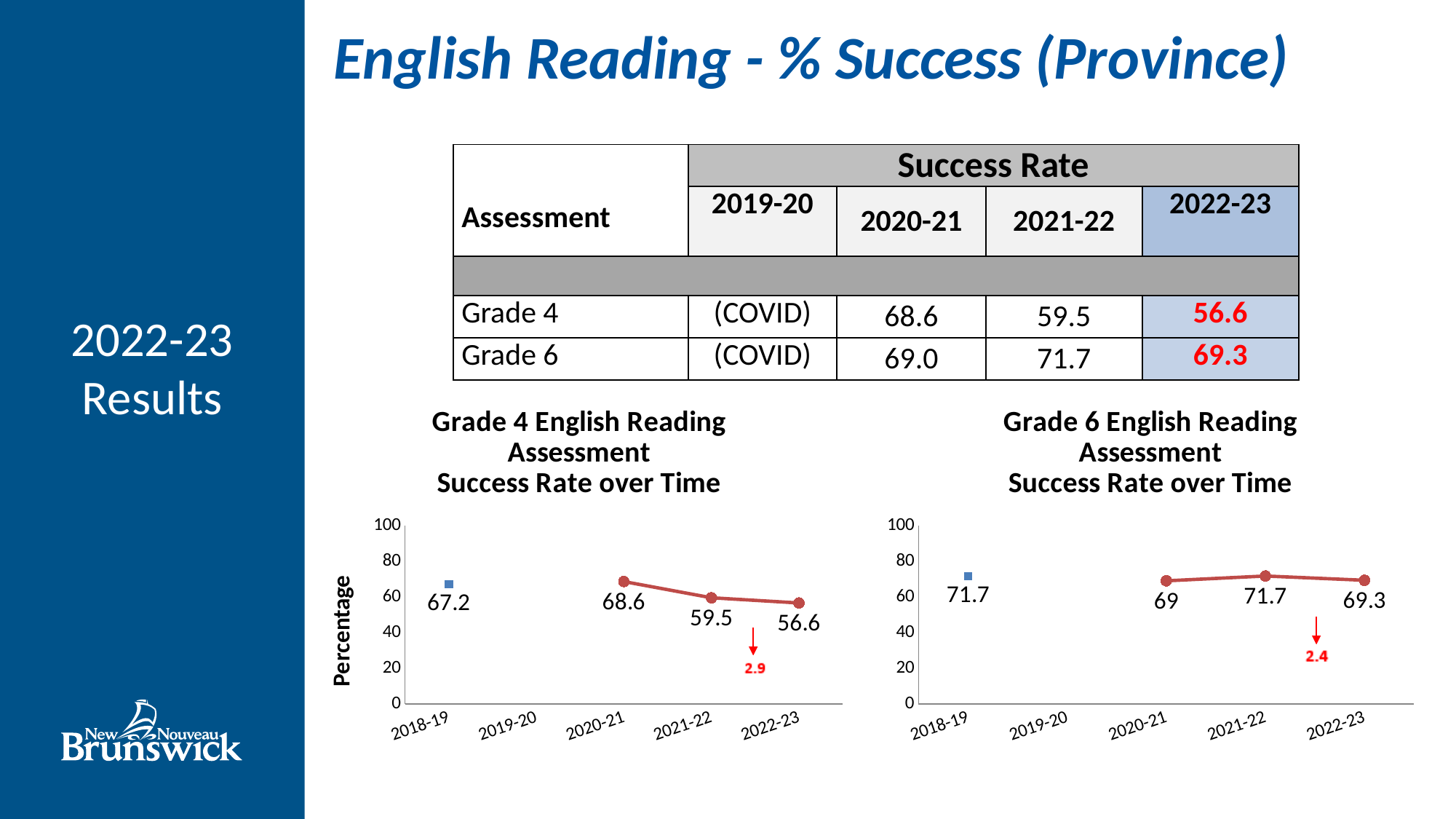
In the Grade 6 English Reading Assessment chart, which year has the lowest success rate? 2020-21 In the Grade 4 English Reading Assessment chart, does the success rate rise or fall from 2020-21 to 2022-23? fall In the Grade 4 English Reading Assessment chart, which year has the lowest success rate? 2022-23 What kind of chart is the Grade 6 English Reading Assessment chart? line chart In the Grade 4 English Reading Assessment chart, which year has the highest success rate? 2020-21 In the Grade 4 English Reading Assessment chart, what is the success rate for 2022-23? 56.6 In the Grade 6 English Reading Assessment chart, is the success rate for 2021-22 or 2022-23 larger? 2021-22 In the Grade 6 English Reading Assessment chart, what is the difference between the 2021-22 and 2022-23 success rates? 2.4 In the Grade 4 English Reading Assessment chart, what is the difference between the 2021-22 and 2022-23 success rates? 2.9 What is the y-axis label on the Grade 4 English Reading Assessment chart? Percentage In the Grade 4 English Reading Assessment chart, what is the value plotted for 2018-19? 67.2 In the Grade 6 English Reading Assessment chart, what is the success rate for 2020-21? 69